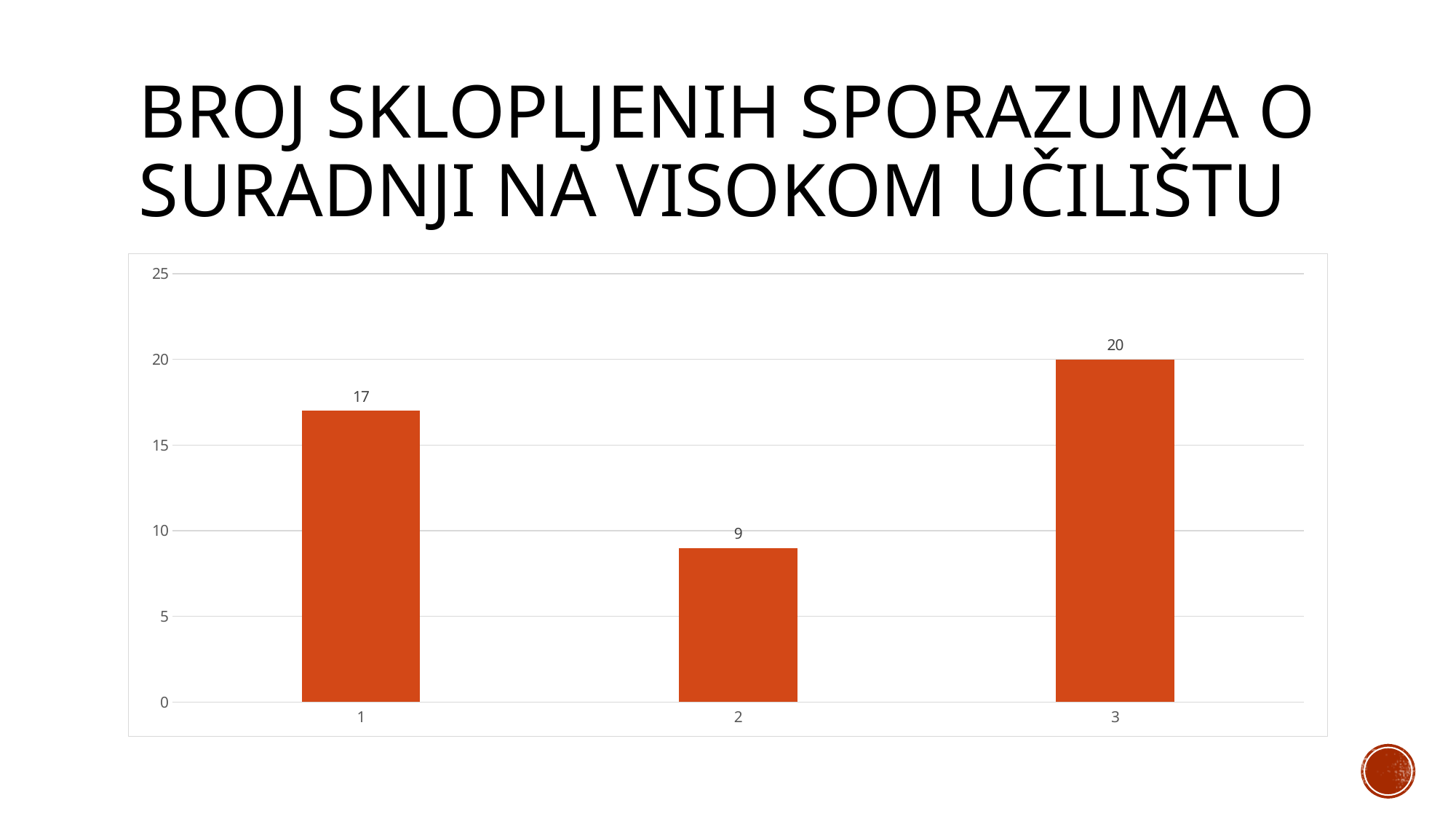
What is the difference between the values for category 1 and category 2? 8 How many categories are shown on the x axis? 3 What is the value for category 3? 20 What is the value for category 1? 17 What is the difference between the values for category 3 and category 1? 3 Which category has the lowest value? 2 What is the title of the slide? BROJ SKLOPLJENIH SPORAZUMA O SURADNJI NA VISOKOM UČILIŠTU Is the value for category 2 greater or less than 10? less What is the value for category 2? 9 Which is larger, the value for category 1 or the value for category 2? category 1 Which category has the highest value? 3 What kind of chart is shown on the slide? bar chart